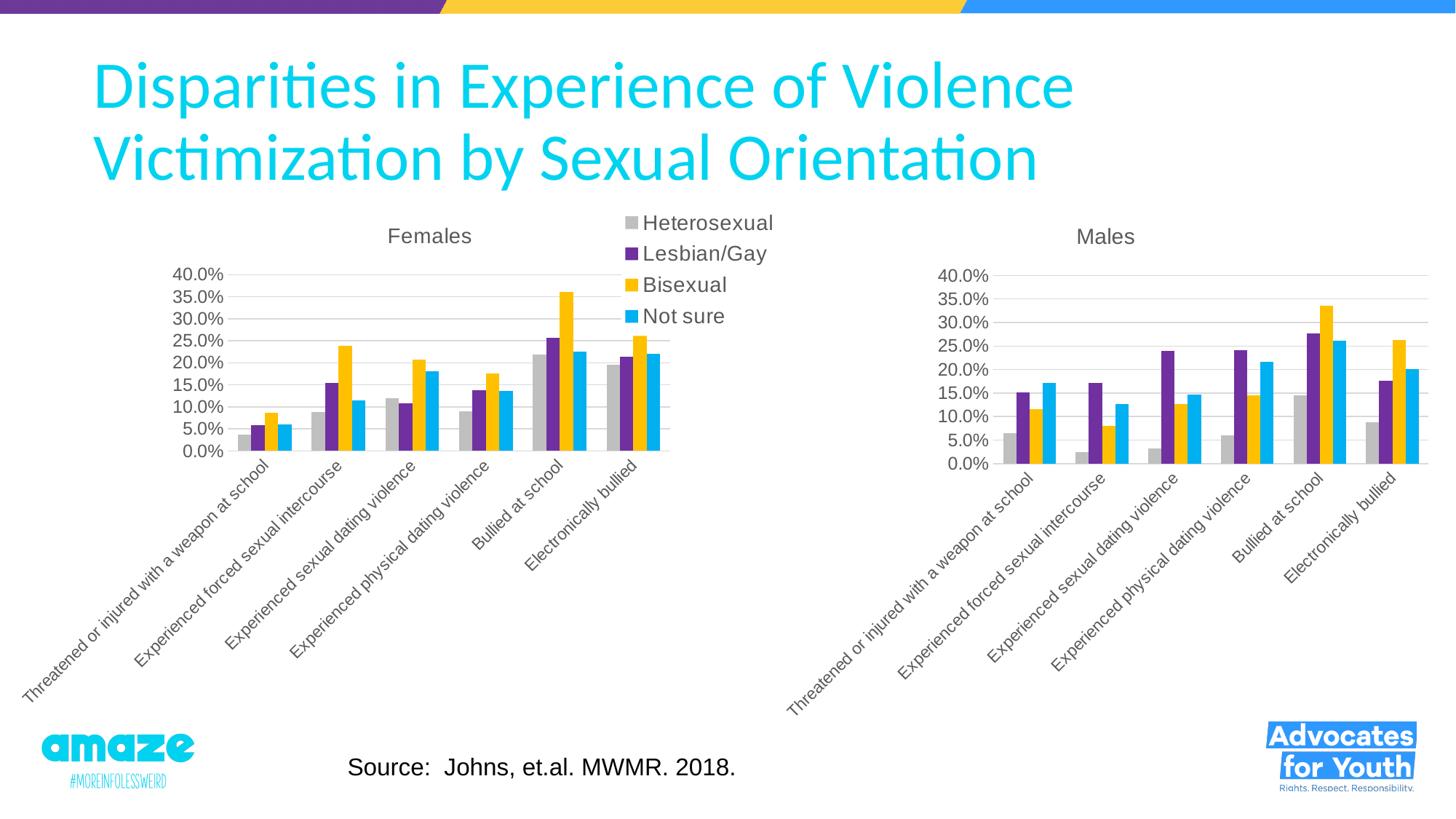
In the Males chart, for Experienced forced sexual intercourse, which is larger: the Lesbian/Gay value or the Bisexual value? Lesbian/Gay How many categories are shown on the x axis of the Males chart? 6 In the Females chart, is the Heterosexual value for Threatened or injured with a weapon at school greater or less than 5.0%? less Which colour represents the Not sure series in the legend? blue In the Males chart, is the Bisexual value for Bullied at school greater or less than 30.0%? greater In the Males chart, is the Heterosexual value for Experienced forced sexual intercourse greater or less than 5.0%? less In the Females chart, which series has the tallest bar for Bullied at school? Bisexual What kind of chart is the Females chart? bar chart How many series does the legend list? 4 In the Males chart, which series has the lowest bar for Experienced forced sexual intercourse? Heterosexual